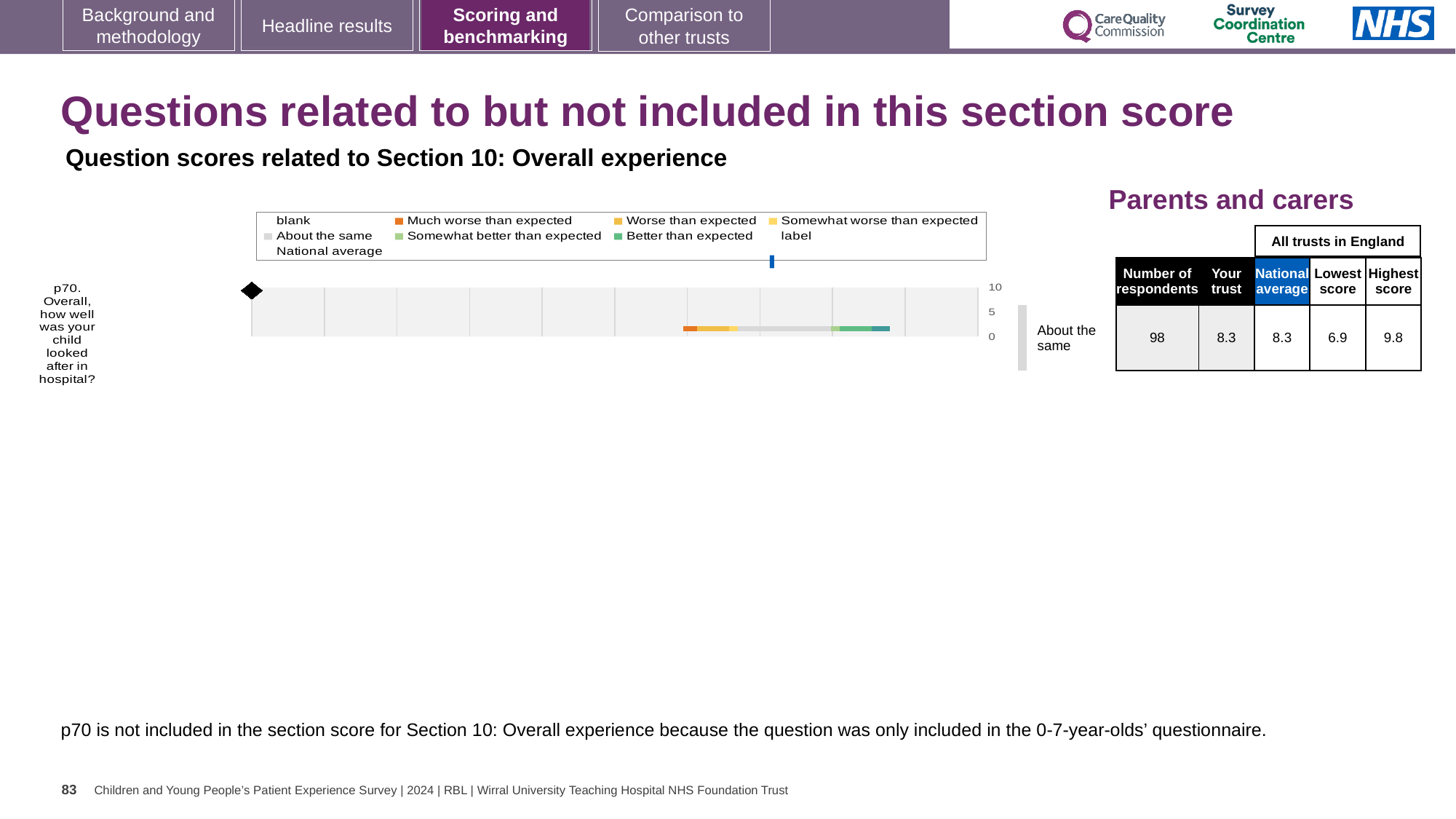
Is the 'Your trust' score for p70 higher than, lower than, or the same as the national average? the same What is the lowest score among all trusts in England for p70? 6.9 How many respondents answered p70? 98 What is the difference between the highest score and the lowest score for p70? 2.9 What benchmark category label is shown to the right of the bar for p70? About the same What is the 'Your trust' score for p70? 8.3 What kind of chart is shown on the slide? bar chart What is the national average score for p70? 8.3 Which survey question is plotted in the chart? p70. Overall, how well was your child looked after in hospital? Is the 'Your trust' score for p70 greater or less than 5? greater What is the highest score among all trusts in England for p70? 9.8 How many survey questions are plotted in the chart? 1